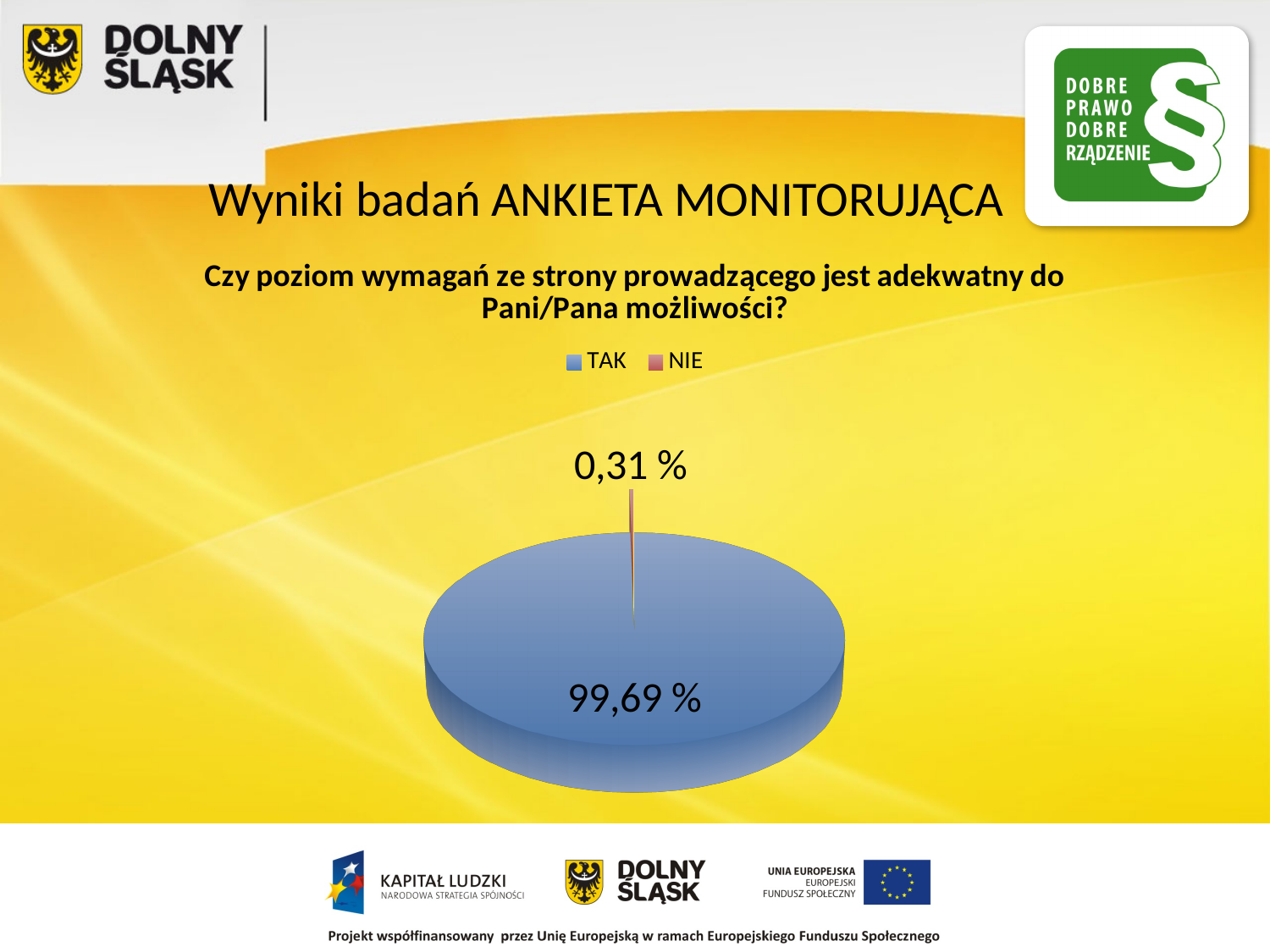
What is the difference between the TAK and NIE values? 99,38 % Which category has the smallest share of the pie? NIE How many categories does the legend list? 2 Which category has the largest share of the pie? TAK What is the value for TAK? 99,69 % What is the value for NIE? 0,31 % How many slices does the pie chart have? 2 What kind of chart is shown on the slide? pie chart What colour is the TAK slice? blue Which is larger, TAK or NIE? TAK What is the title of the chart? Czy poziom wymagań ze strony prowadzącego jest adekwatny do Pani/Pana możliwości?